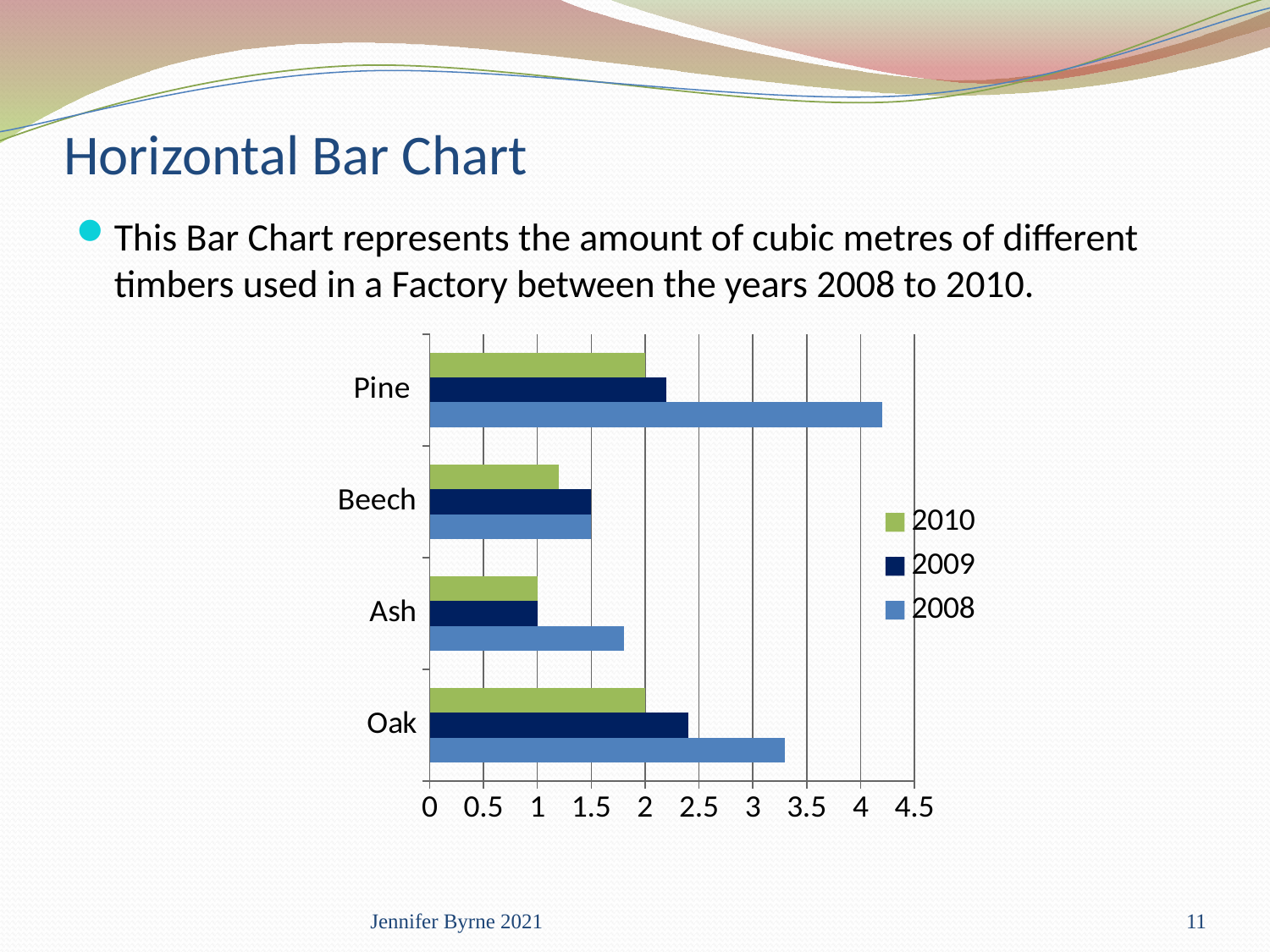
Which timber has the lowest value for 2008? Beech How many series does the legend list? 3 How many timber categories are shown on the chart? 4 Is the 2008 value for Pine greater or less than 4? greater Which is larger, the 2008 value for Oak or the 2008 value for Pine? Pine Which timber has the highest value for 2009? Oak Is the 2008 value for Ash greater or less than 1.5? greater What kind of chart is shown on the slide? bar chart Is the 2008 value for Oak greater or less than 3? greater Which timber has the highest value for 2008? Pine Which years are listed in the chart's legend? 2010, 2009, 2008